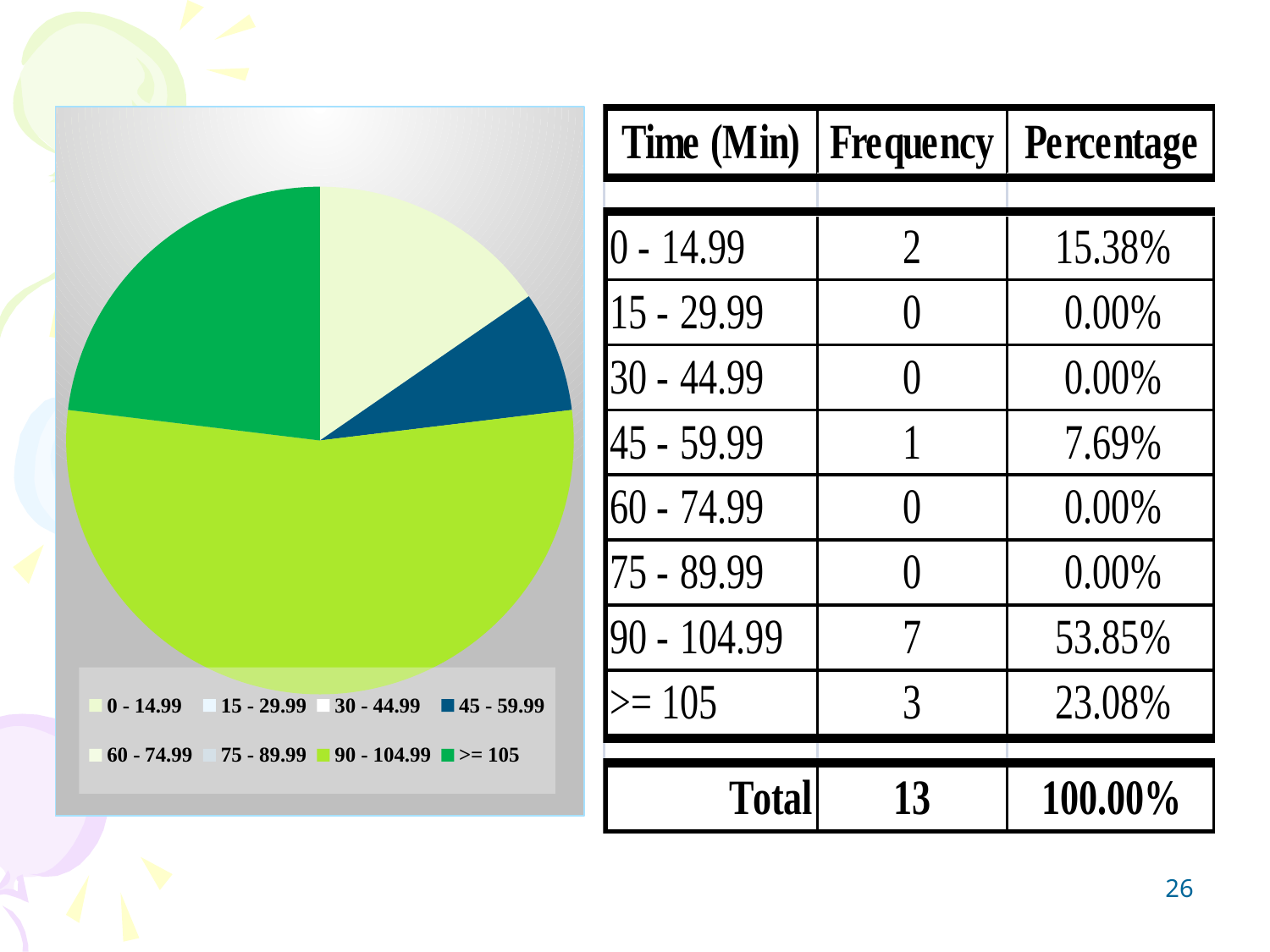
Which category has the largest slice of the pie chart? 90 - 104.99 Which of the visible slices in the pie chart is the smallest? 45 - 59.99 Which slice is larger in the pie chart, >= 105 or 0 - 14.99? >= 105 What kind of chart is shown on the left of the slide? pie chart What share of the pie does the 90 - 104.99 slice represent? 53.85% What share of the pie does the >= 105 slice represent? 23.08% What colour is the 45 - 59.99 slice in the pie chart? dark blue Which slice is larger in the pie chart, 0 - 14.99 or 45 - 59.99? 0 - 14.99 What share of the pie does the 0 - 14.99 slice represent? 15.38% How many slices are visibly drawn in the pie chart (categories with a non-zero value)? 4 How many categories does the pie chart's legend list? 8